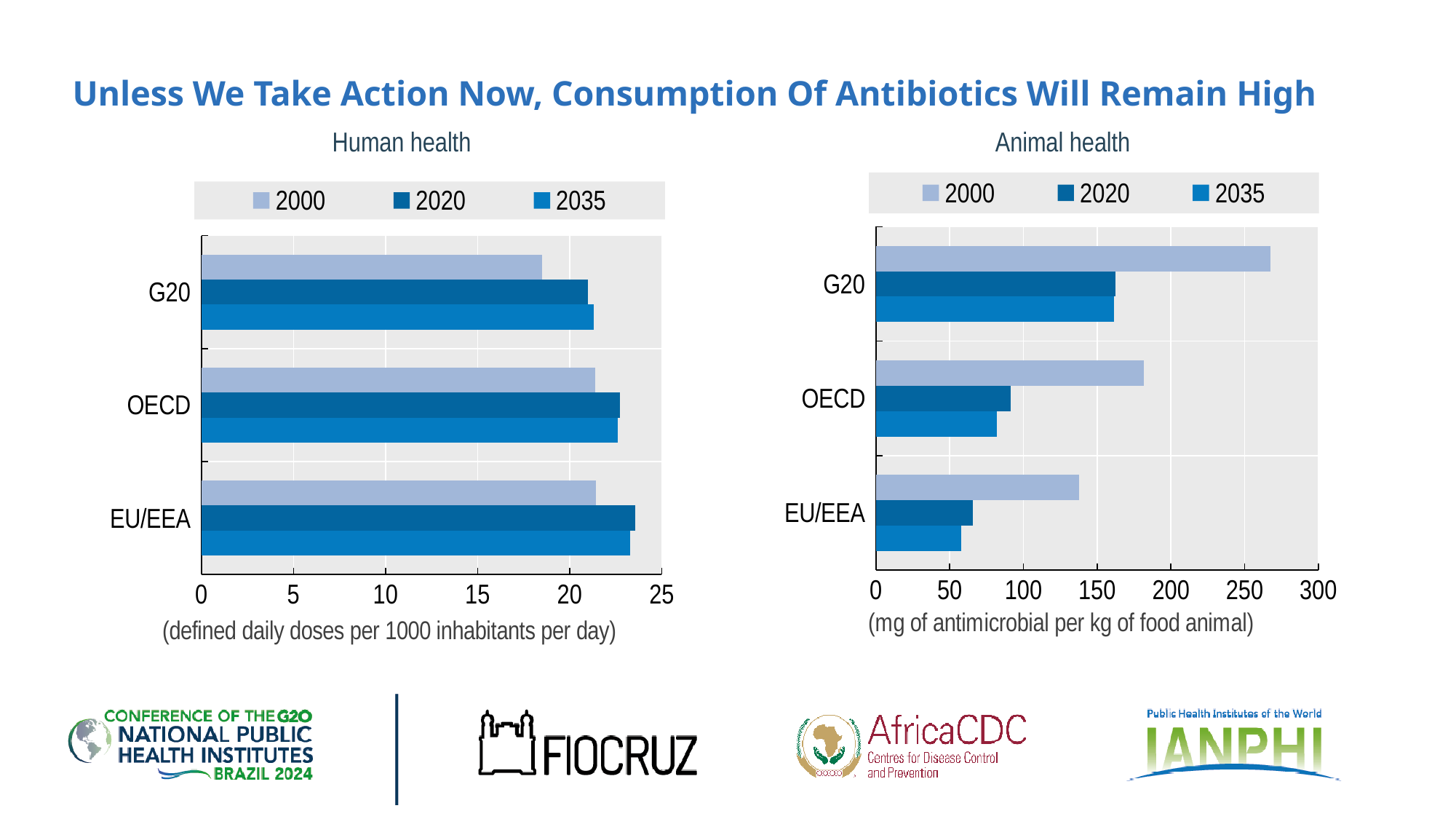
On the Animal health chart, which category has the lowest value for 2035? EU/EEA On the Human health chart, how many series does the legend list? 3 On the Animal health chart, what unit is given below the horizontal axis? mg of antimicrobial per kg of food animal On the Animal health chart, is the value for EU/EEA in 2035 greater or less than 100? less On the Animal health chart, which category has the highest value for 2000? G20 On the Human health chart, which category has the lowest value for 2000? G20 On the Animal health chart, how many categories are shown on the vertical axis? 3 On the Animal health chart, is the value for G20 in 2000 greater or less than 250? greater On the Animal health chart, which is larger for OECD: the 2000 value or the 2020 value? 2000 On the Human health chart, is the value for G20 in 2000 greater or less than 20? less On the Human health chart, what kind of chart is shown? bar chart